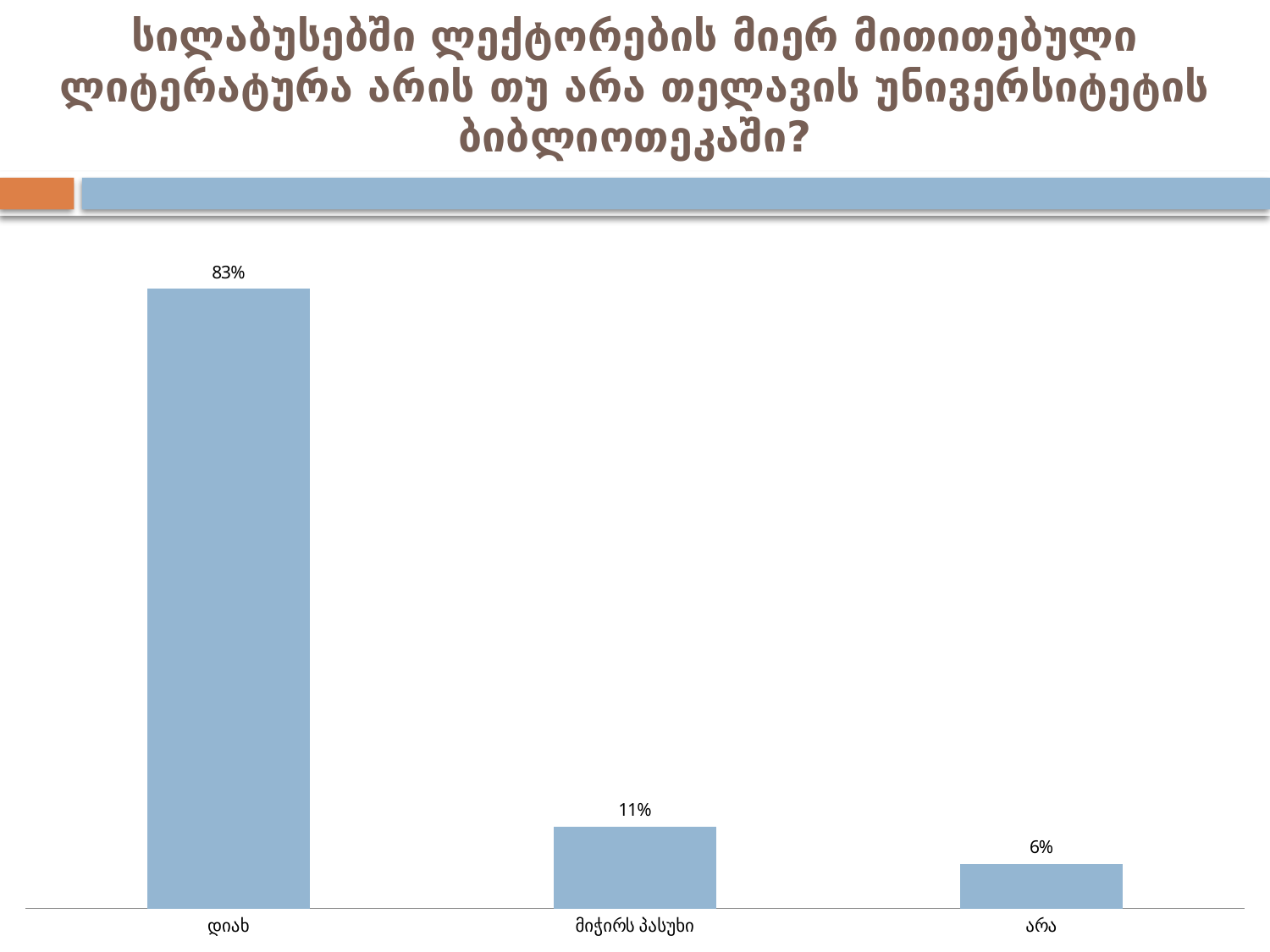
What is the value for არა? 6% How many categories are shown on the chart? 3 Which is larger, the value for მიჭირს პასუხი or the value for არა? მიჭირს პასუხი What kind of chart is shown on the slide? bar chart Which category has the highest value? დიახ Which category has the lowest value? არა Do the values rise or fall from left to right along the x axis? fall What is the difference between the values for მიჭირს პასუხი and არა? 5% What is the value for დიახ? 83% What is the difference between the values for დიახ and არა? 77% What is the value for მიჭირს პასუხი? 11% What colour are the bars in the chart? light blue